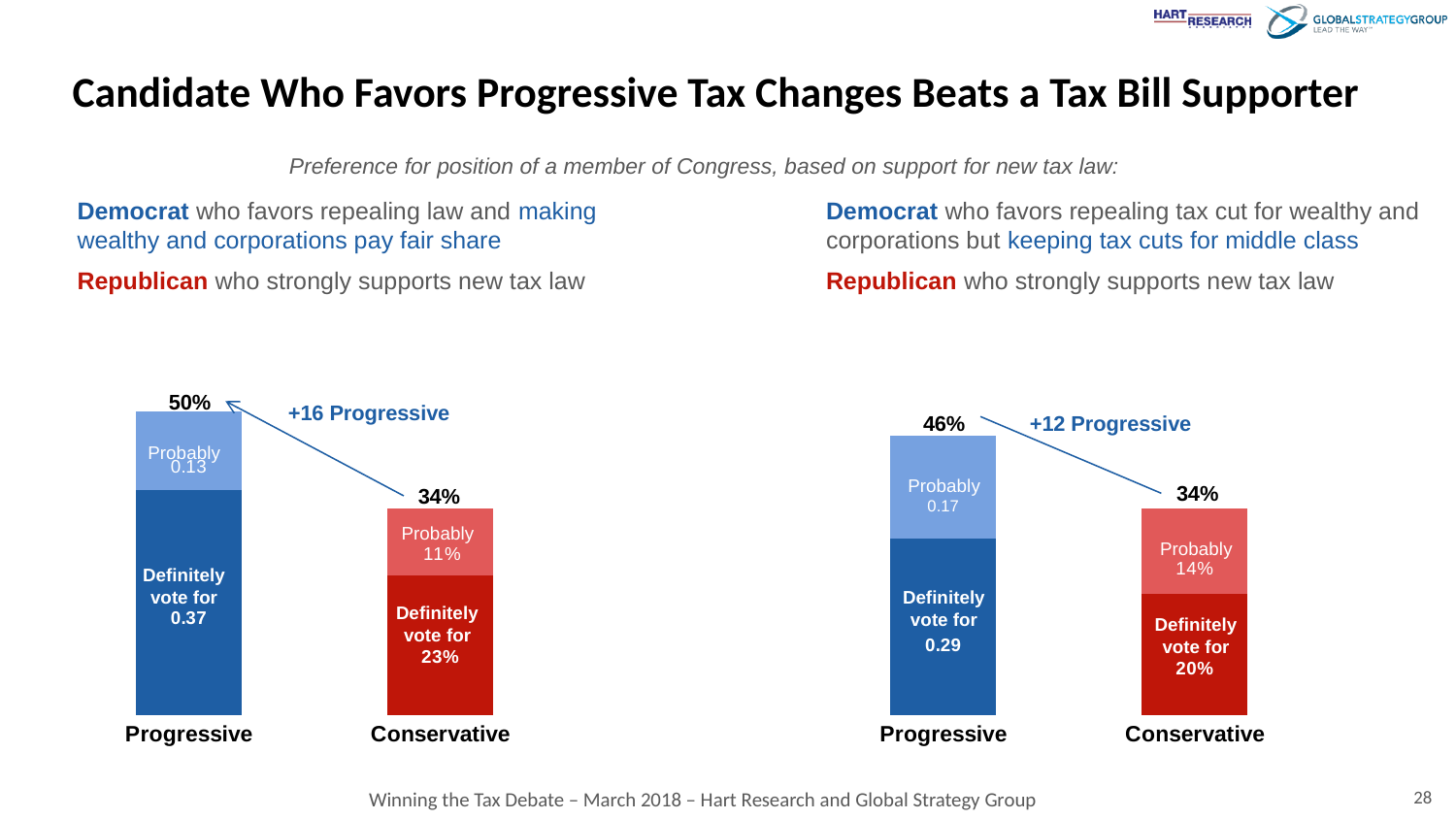
In the left chart, what is the 'Probably' value for the Progressive bar? 0.13 What kind of chart is the left chart? Stacked bar chart In the left chart, which category has the higher total, Progressive or Conservative? Progressive In the left chart, what is the total value shown above the Progressive bar? 50% In the right chart, what is the total value shown above the Progressive bar? 46% In the right chart, what is the 'Probably' value for the Conservative bar? 14% In the right chart, what is the difference between the Progressive total and the Conservative total? 12 What advantage label is shown between the bars in the left chart? +16 Progressive How many categories are shown on the x axis of the right chart? 2 In the right chart, what is the 'Definitely vote for' value for the Conservative bar? 20% In the left chart, what is the difference between the 'Definitely vote for' value for Conservative and the 'Probably' value for Conservative? 12% In the left chart, what is the 'Definitely vote for' value for the Conservative bar? 23%